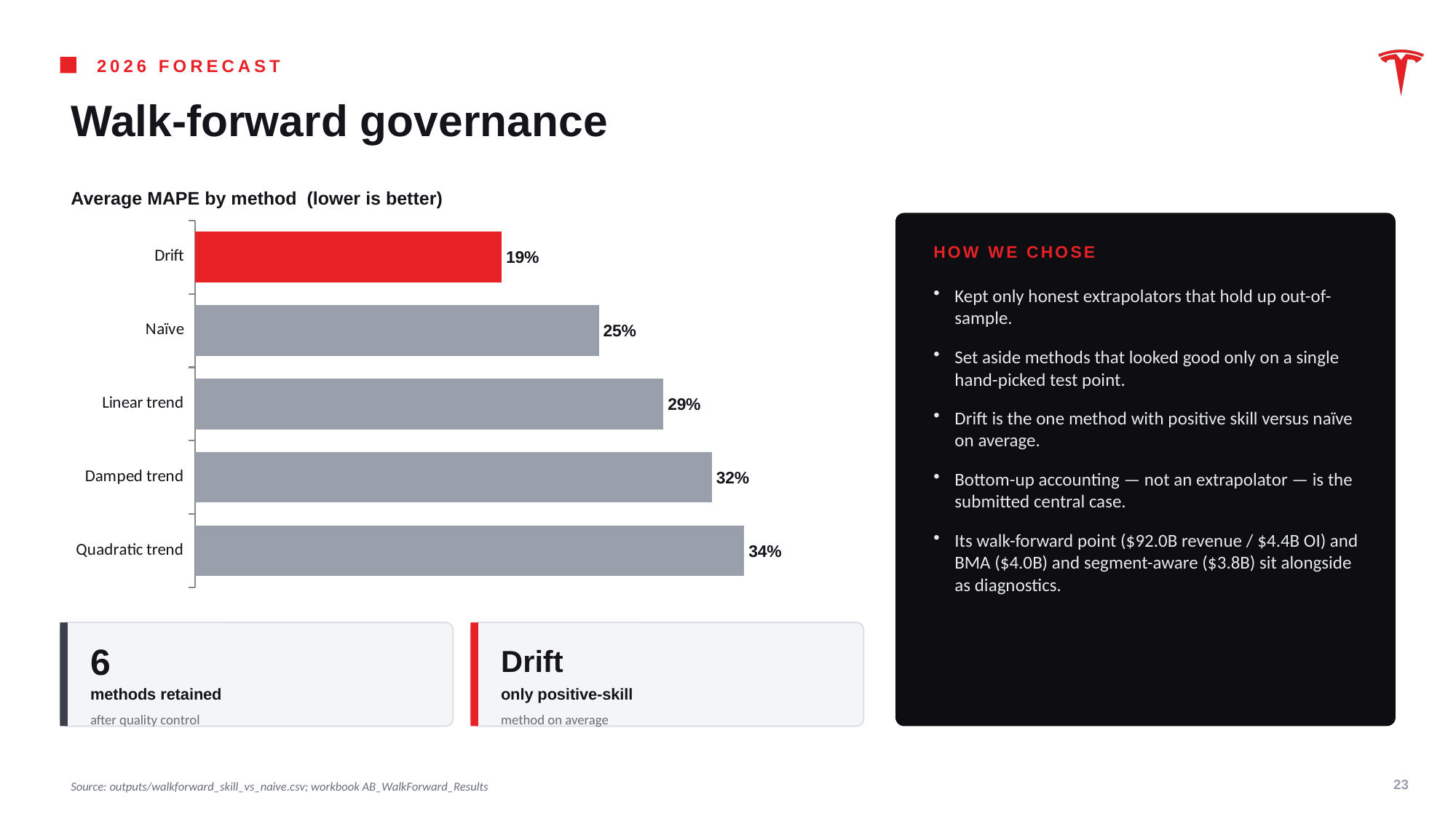
What is the difference in average MAPE between Quadratic trend and Drift? 15% Which has a higher average MAPE, Damped trend or Linear trend? Damped trend Which bar in the chart is coloured red? Drift What is the average MAPE for the Quadratic trend method? 34% What is the difference in average MAPE between Linear trend and Naïve? 4% How many methods are shown in the chart? 5 What is the average MAPE for the Naïve method? 25% What type of chart is used to show average MAPE by method? Bar chart What is the title of the chart? Average MAPE by method (lower is better) What is the average MAPE for the Drift method? 19% Which method has the highest average MAPE? Quadratic trend Which method has the lowest average MAPE? Drift